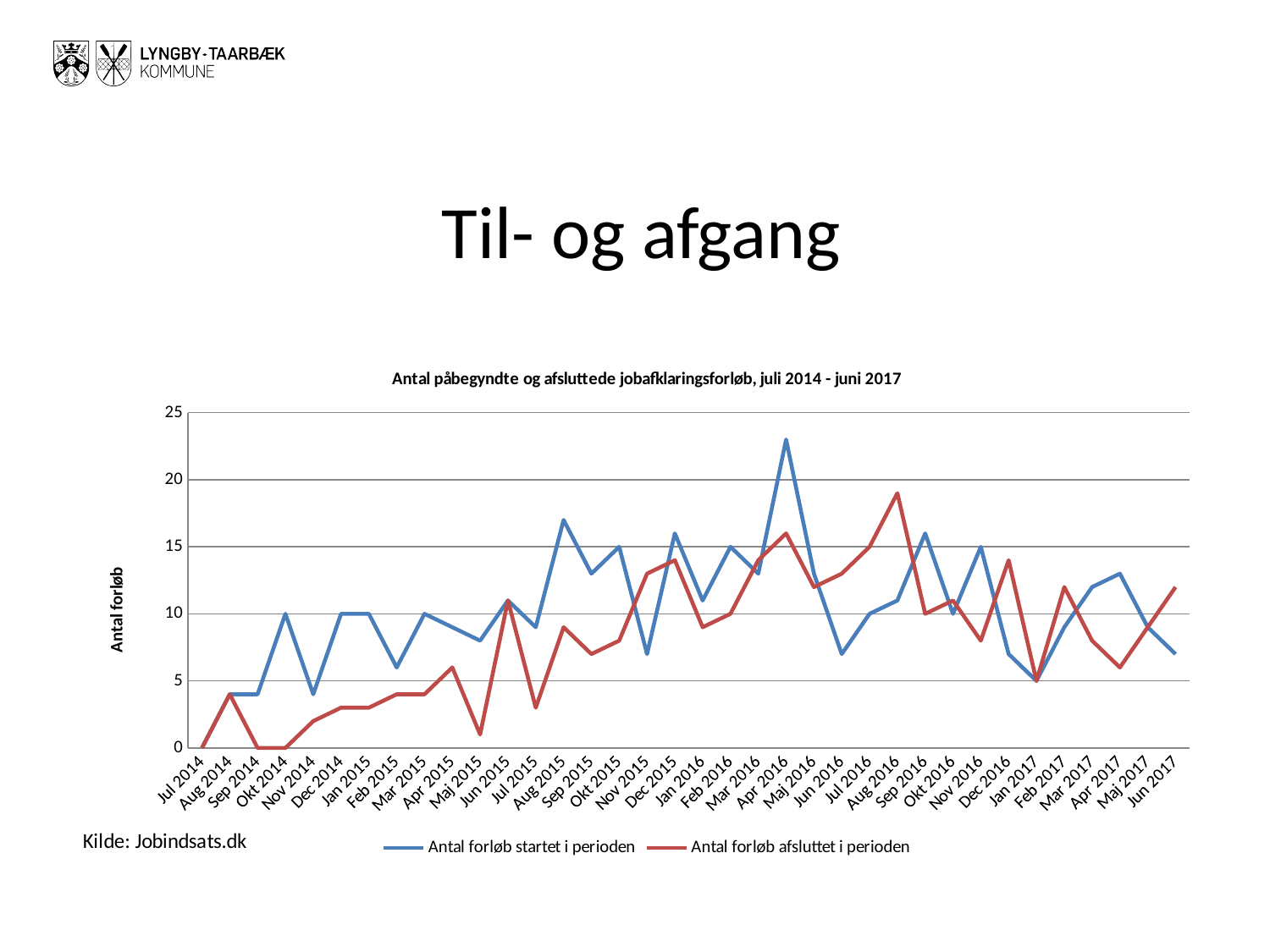
In Apr 2016, which series has the larger value, 'Antal forløb startet i perioden' or 'Antal forløb afsluttet i perioden'? Antal forløb startet i perioden What is the value for 'Antal forløb afsluttet i perioden' in Sep 2014? 0 What is the title of the chart? Antal påbegyndte og afsluttede jobafklaringsforløb, juli 2014 - juni 2017 What kind of chart is shown on the slide? line chart How many series does the legend list? 2 In which month does 'Antal forløb startet i perioden' reach its highest value? Apr 2016 How many months are plotted along the x axis? 36 Is the value for 'Antal forløb startet i perioden' in Apr 2016 greater or less than 20? greater In Dec 2016, which series has the larger value, 'Antal forløb startet i perioden' or 'Antal forløb afsluttet i perioden'? Antal forløb afsluttet i perioden Is the value for 'Antal forløb afsluttet i perioden' in Maj 2015 greater or less than 5? less Is the value for 'Antal forløb afsluttet i perioden' in Aug 2016 greater or less than 15? greater In which month does 'Antal forløb afsluttet i perioden' reach its highest value? Aug 2016